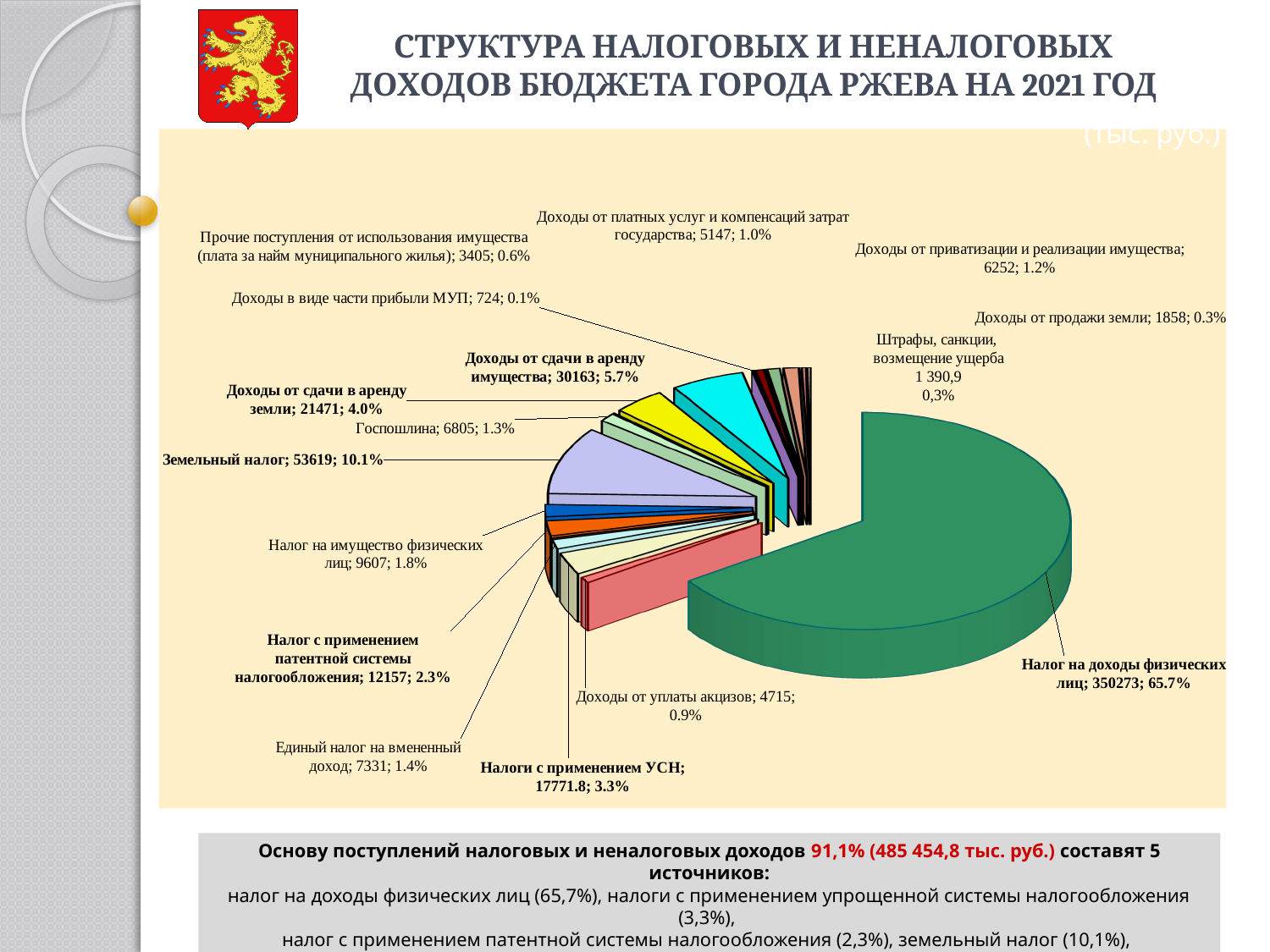
What is the title of the slide containing the chart? СТРУКТУРА НАЛОГОВЫХ И НЕНАЛОГОВЫХ ДОХОДОВ БЮДЖЕТА ГОРОДА РЖЕВА НА 2021 ГОД What value is shown for Налог на доходы физических лиц? 350273 Which is larger: Госпошлина or Доходы от уплаты акцизов? Госпошлина What percentage is shown for Доходы от сдачи в аренду имущества? 5.7% How many categories (slices) does the pie chart have? 19 What value is shown for Налоги с применением УСН? 17771.8 What kind of chart is shown on the slide? Pie chart Which category has the largest slice of the pie? Налог на доходы физических лиц What is the difference between the values for Земельный налог and Доходы от сдачи в аренду имущества? 23456 What share of the pie does Земельный налог represent? 10.1% What value is shown for Налог с применением патентной системы налогообложения? 12157